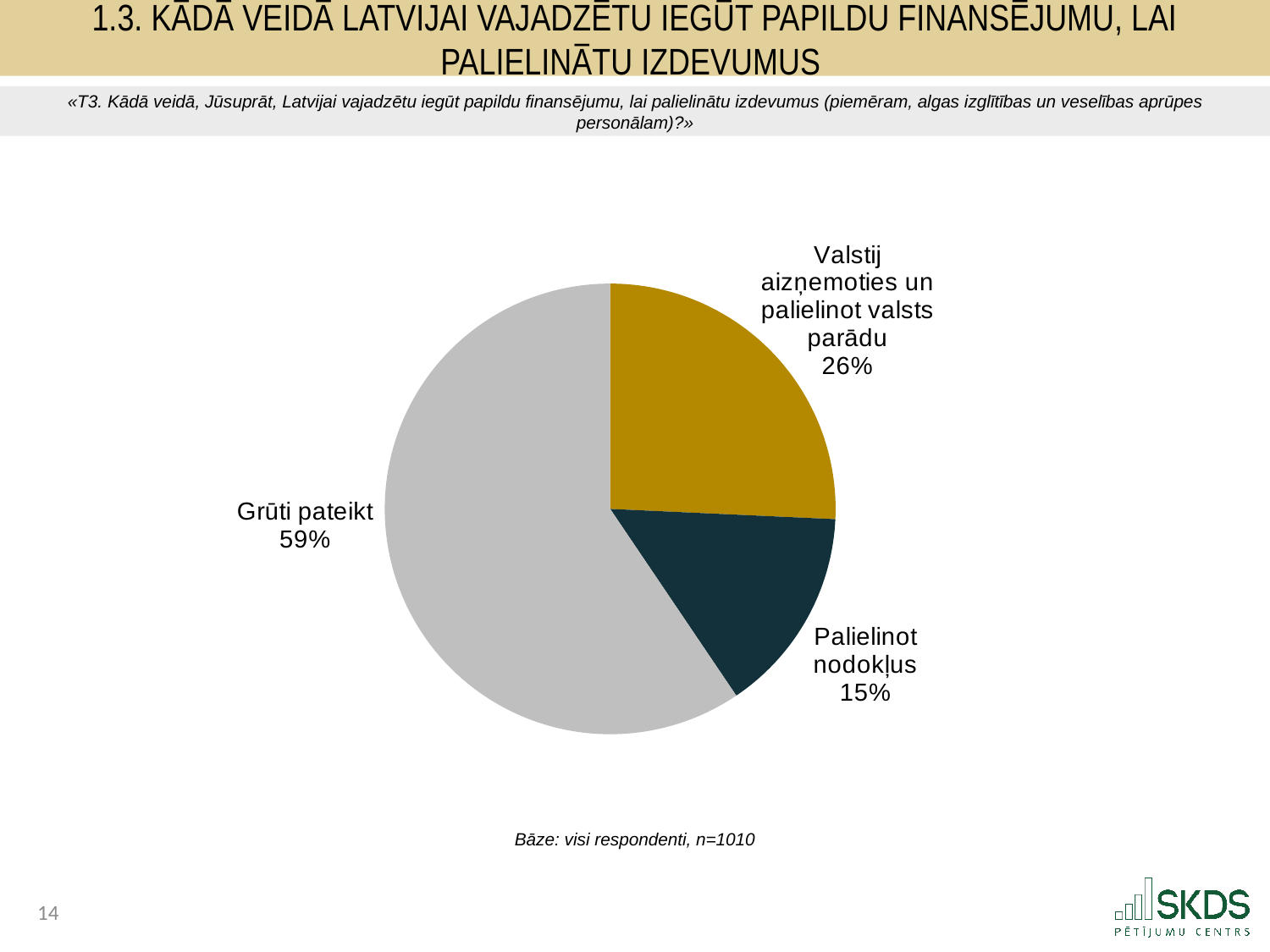
How many slices does the pie chart have? 3 What kind of chart is shown on the slide? pie chart What is the difference in percentage points between "Valstij aizņemoties un palielinot valsts parādu" and "Palielinot nodokļus"? 11 percentage points What is the difference in percentage points between "Grūti pateikt" and "Valstij aizņemoties un palielinot valsts parādu"? 33 percentage points What colour is the "Grūti pateikt" slice? grey What share of respondents chose "Palielinot nodokļus"? 15% Which slice of the pie is the largest? Grūti pateikt What is the base (number of respondents) stated below the chart? n=1010 Which is larger: the share for "Valstij aizņemoties un palielinot valsts parādu" or for "Palielinot nodokļus"? Valstij aizņemoties un palielinot valsts parādu What share of respondents chose "Valstij aizņemoties un palielinot valsts parādu"? 26% Which slice of the pie is the smallest? Palielinot nodokļus What share of respondents answered "Grūti pateikt"? 59%